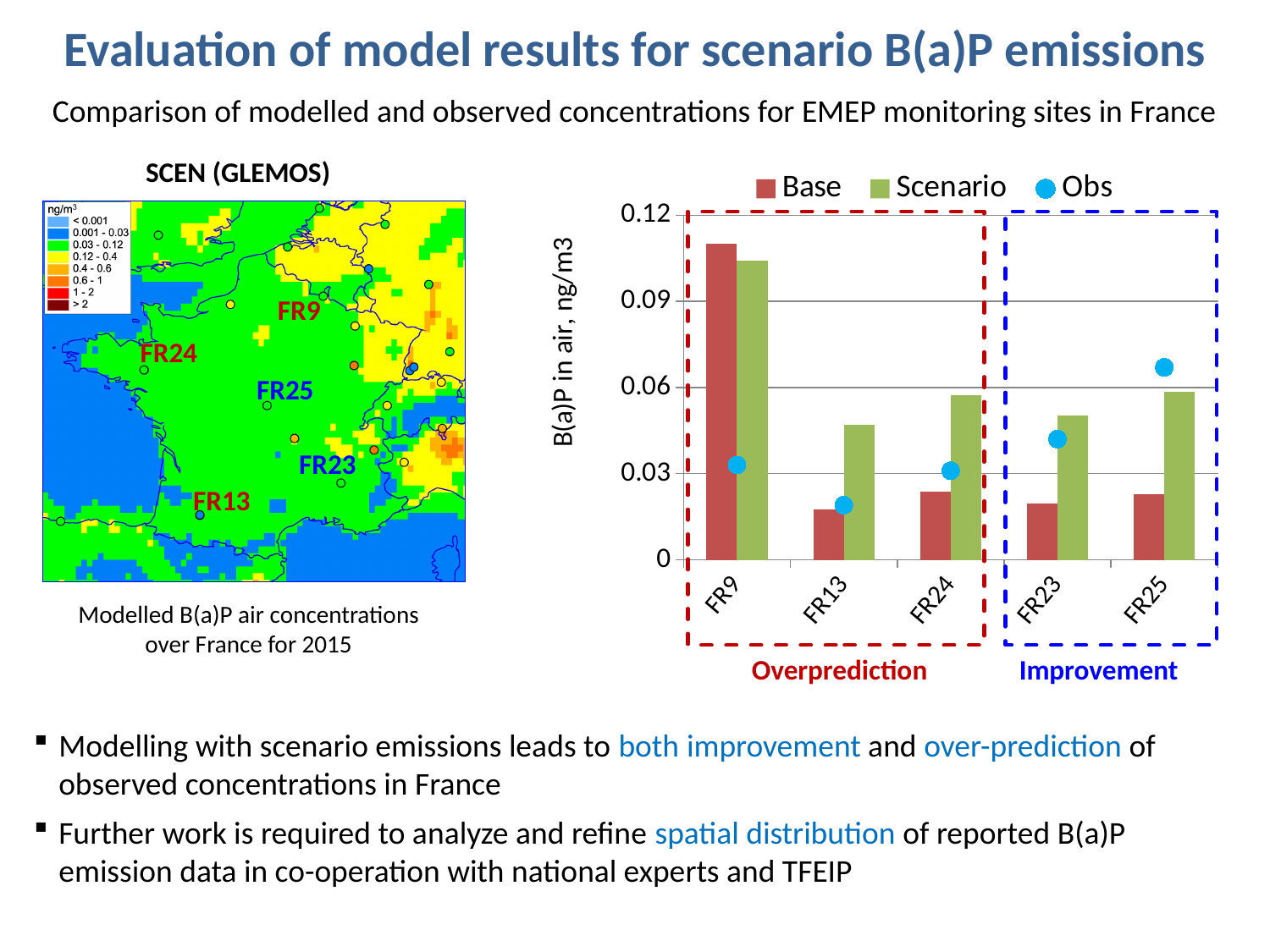
How many monitoring sites are shown on the x axis of the bar chart? 5 What kind of chart is shown on the right side of the slide? bar chart Is the Obs value for FR25 greater or less than 0.06? greater Is the Base value for FR13 greater or less than 0.03? less Is the Scenario value for FR23 greater or less than 0.03? greater Which sites are grouped under the 'Improvement' label in the bar chart? FR23 and FR25 Which site has the highest Scenario value in the bar chart? FR9 Which site has the highest Base value in the bar chart? FR9 How many series does the legend of the bar chart list? 3 For FR13, which is larger, the Base value or the Scenario value? Scenario What is the label of the y axis of the bar chart? B(a)P in air, ng/m3